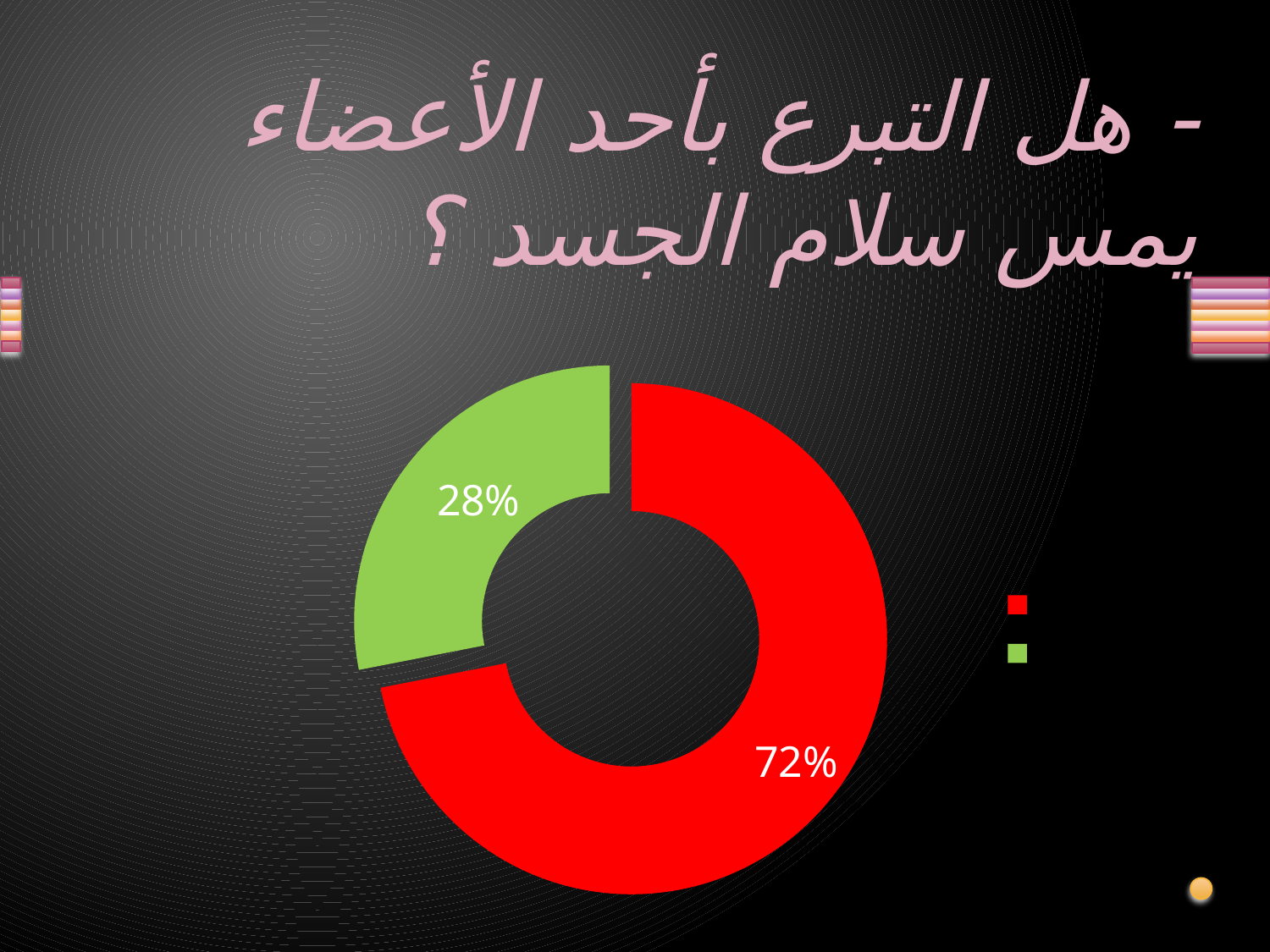
What colours are the two slices of the doughnut chart? Red and green Which slice of the doughnut chart is the smallest? The green slice (28%) What is the difference in percentage points between the red slice and the green slice? 44 percentage points What percentage is shown on the green slice of the doughnut chart? 28% What percentage is shown on the red slice of the doughnut chart? 72% What share of the doughnut does the green slice represent? 28% Which is larger, the red slice or the green slice? The red slice What do the two slice percentages add up to? 100% How many entries does the legend list? 2 What kind of chart is shown on the slide? Doughnut chart Which slice of the doughnut chart is the largest? The red slice (72%) How many slices does the doughnut chart have? 2